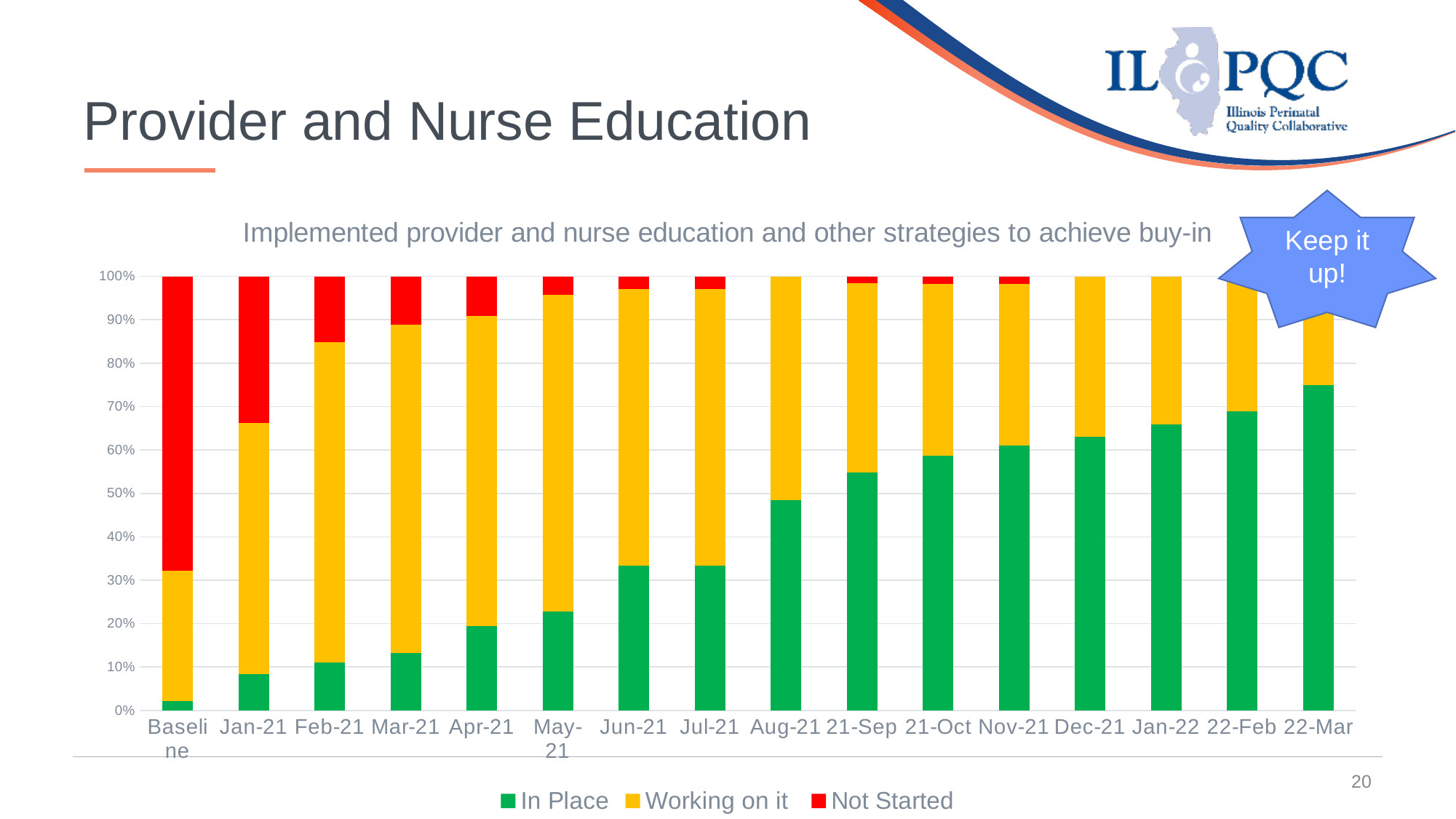
Is the In Place value for Baseline greater or less than 10%? less Which category has the largest Not Started share? Baseline How many time periods (categories) are shown on the x axis? 16 What kind of chart is shown on the slide? Stacked bar chart How many series does the legend list? 3 Is the In Place value for 22-Mar greater or less than 70%? greater Is the Not Started value for Baseline greater or less than 60%? greater Which is larger, the In Place value for Jan-22 or for Feb-21? Jan-22 Does the In Place series rise or fall from Baseline to 22-Mar? Rises Which category has the highest In Place value? 22-Mar What is the title of the chart? Implemented provider and nurse education and other strategies to achieve buy-in Which category has the lowest In Place value? Baseline